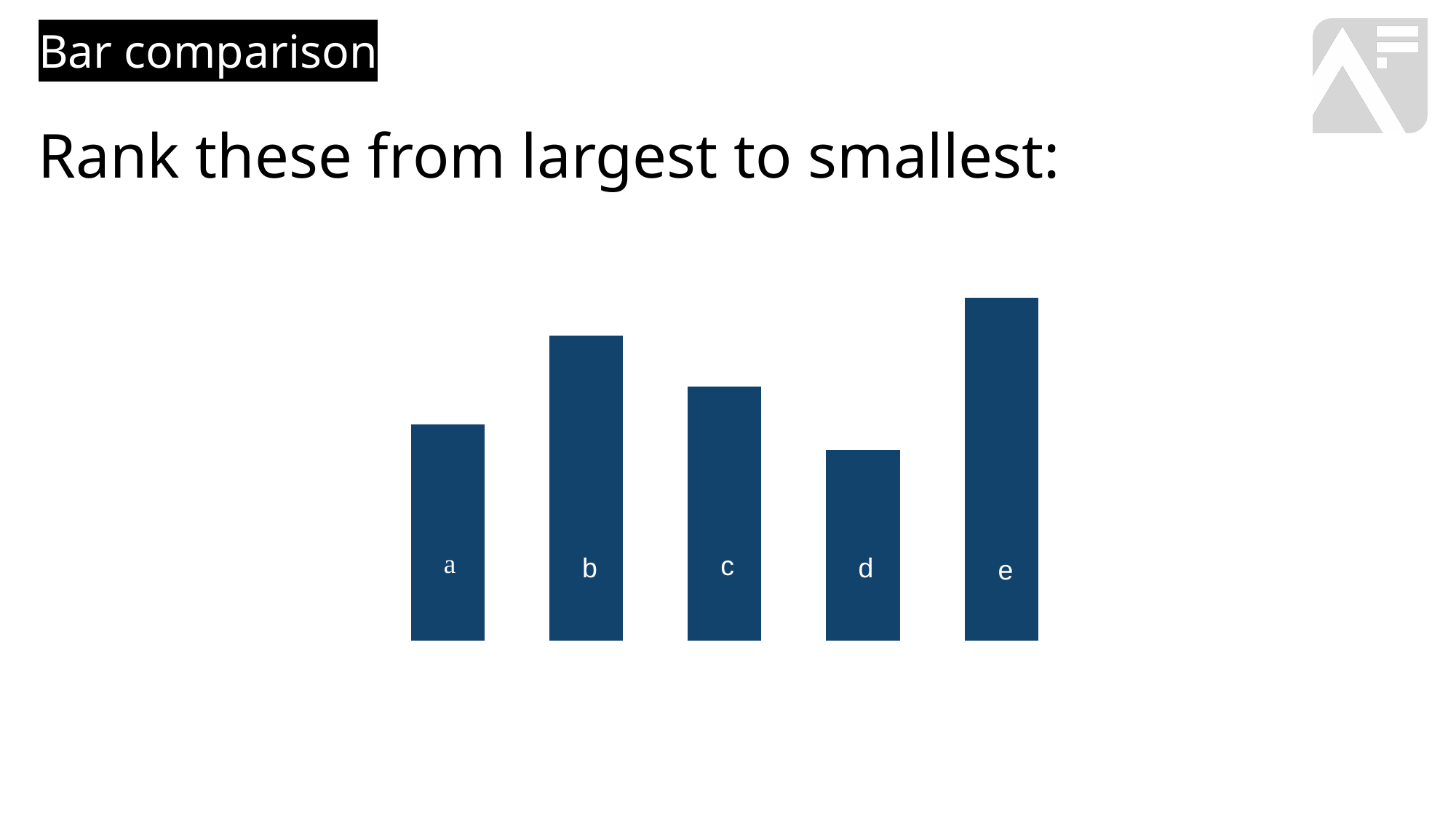
Which bar is the shortest? d How many bars are shown in the chart? 5 Which bar is taller, e or b? e Which bar is the second tallest? b What is the title shown in the black box at the top left of the slide? Bar comparison Which bar is the tallest? e What are the labels of the bars, from left to right? a, b, c, d, e Which bar is taller, a or d? a Which bar is taller, c or a? c What kind of chart is shown on the slide? bar chart